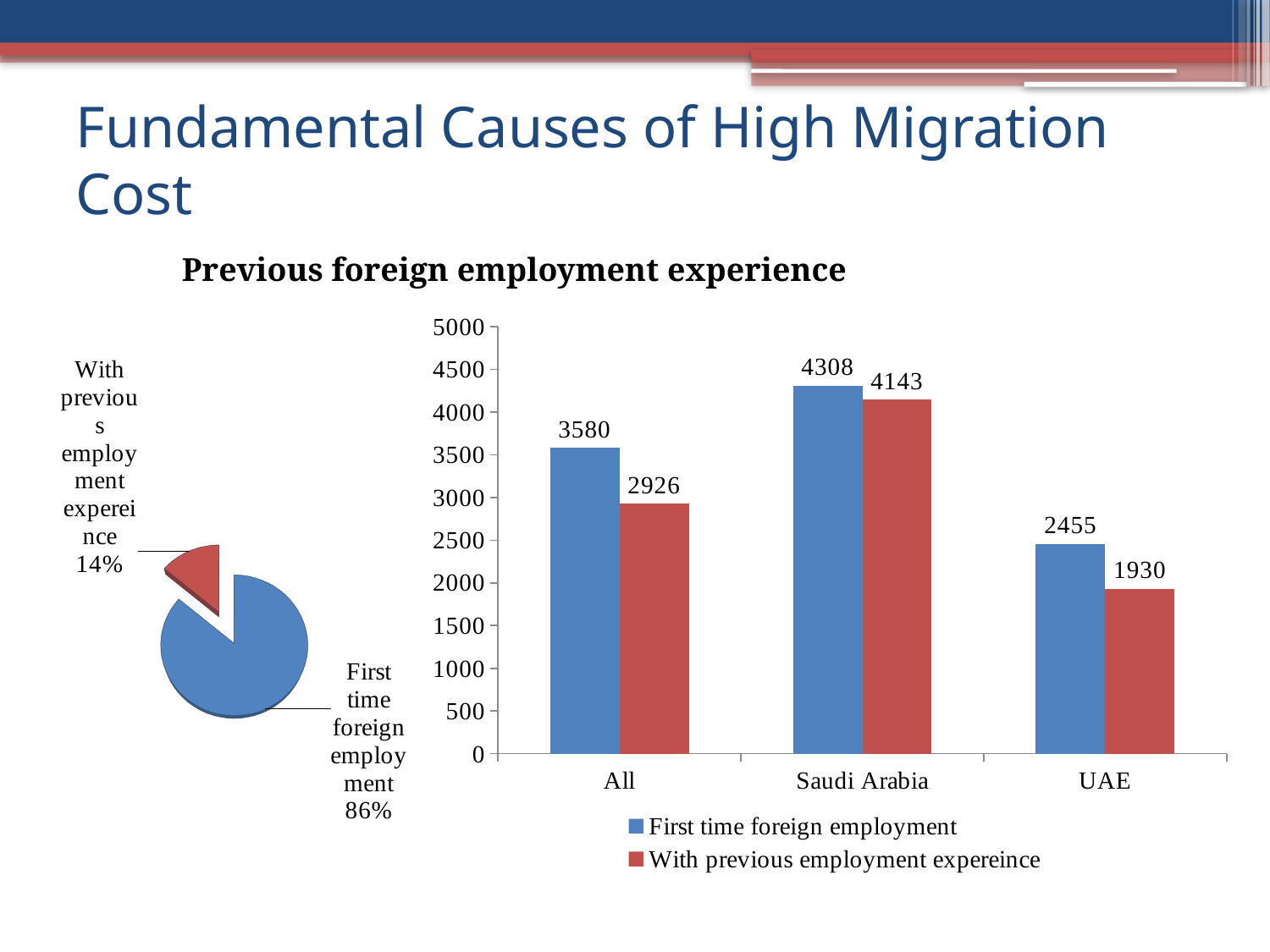
In the bar chart on the right, what is the value for First time foreign employment in Saudi Arabia? 4308 In the bar chart on the right, which category has the lowest value for With previous employment experience? UAE In the bar chart on the right, which is larger for Saudi Arabia: First time foreign employment or With previous employment experience? First time foreign employment In the bar chart on the right, which category has the highest value for First time foreign employment? Saudi Arabia In the bar chart on the right, how many categories are shown on the x axis? 3 In the bar chart on the right, what is the difference between First time foreign employment and With previous employment experience for All? 654 In the bar chart on the right, what is the value for With previous employment experience for All? 2926 In the bar chart on the right, how many series does the legend list? 2 What kind of chart is shown on the left of the slide? Pie chart In the pie chart on the left, what share of the pie is First time foreign employment? 86% In the bar chart on the right, what is the difference between First time foreign employment and With previous employment experience in UAE? 525 In the bar chart on the right, what is the value for With previous employment experience in UAE? 1930